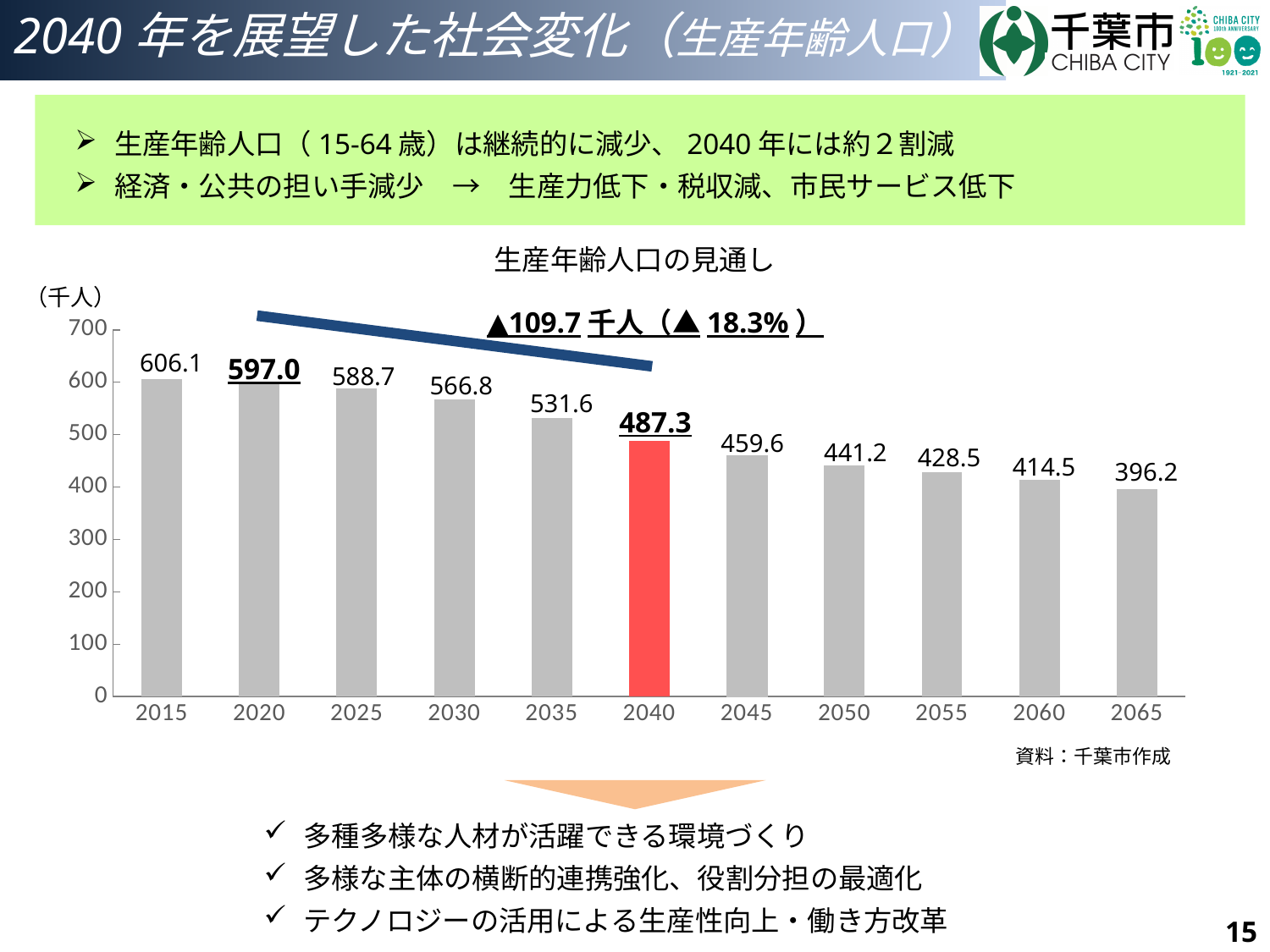
What is the value for 2015 in the 生産年齢人口の見通し chart? 606.1 Do the values in the 生産年齢人口の見通し chart rise or fall from 2015 to 2065? fall How many years are shown on the x axis of the 生産年齢人口の見通し chart? 11 Which year has the lowest value in the 生産年齢人口の見通し chart? 2065 Is the value for 2045 in the 生産年齢人口の見通し chart greater or less than 500? less Which year's bar is highlighted in red in the 生産年齢人口の見通し chart? 2040 What is the difference between the values for 2020 and 2040 in the 生産年齢人口の見通し chart? 109.7 Which year has the highest value in the 生産年齢人口の見通し chart? 2015 Which is larger in the 生産年齢人口の見通し chart, the value for 2030 or the value for 2050? 2030 What is the value for 2065 in the 生産年齢人口の見通し chart? 396.2 What is the value for 2040 in the 生産年齢人口の見通し chart? 487.3 What kind of chart is the 生産年齢人口の見通し chart? bar chart